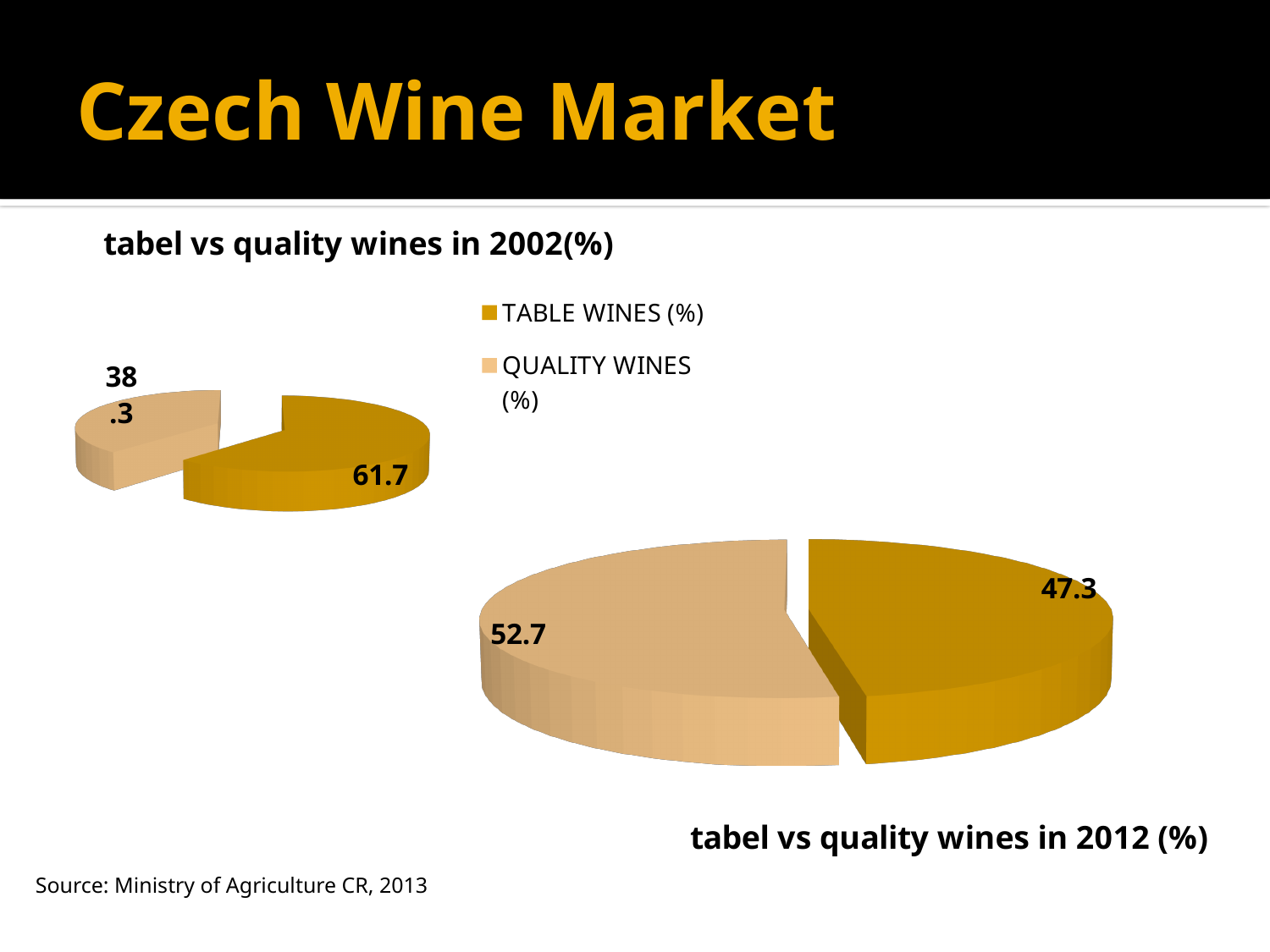
In the 'tabel vs quality wines in 2012 (%)' chart, what is the difference between the QUALITY WINES (%) and TABLE WINES (%) values? 5.4 In the 'tabel vs quality wines in 2002(%)' chart, what is the difference between the TABLE WINES (%) and QUALITY WINES (%) values? 23.4 In the 'tabel vs quality wines in 2002(%)' chart, what is the value for TABLE WINES (%)? 61.7 In the 'tabel vs quality wines in 2012 (%)' chart, what is the value for TABLE WINES (%)? 47.3 Is the TABLE WINES (%) value larger in the 2002 chart or in the 2012 chart? 2002 In the 'tabel vs quality wines in 2002(%)' chart, which category has the largest slice? TABLE WINES (%) How many categories does the legend list for the pie charts? 2 In the 'tabel vs quality wines in 2012 (%)' chart, which category has the smallest slice? TABLE WINES (%) In the 'tabel vs quality wines in 2002(%)' chart, what is the value for QUALITY WINES (%)? 38.3 In the 'tabel vs quality wines in 2012 (%)' chart, what is the value for QUALITY WINES (%)? 52.7 Which colour represents QUALITY WINES (%) in the pie charts? Light tan What kind of chart is the 'tabel vs quality wines in 2012 (%)' chart? Pie chart